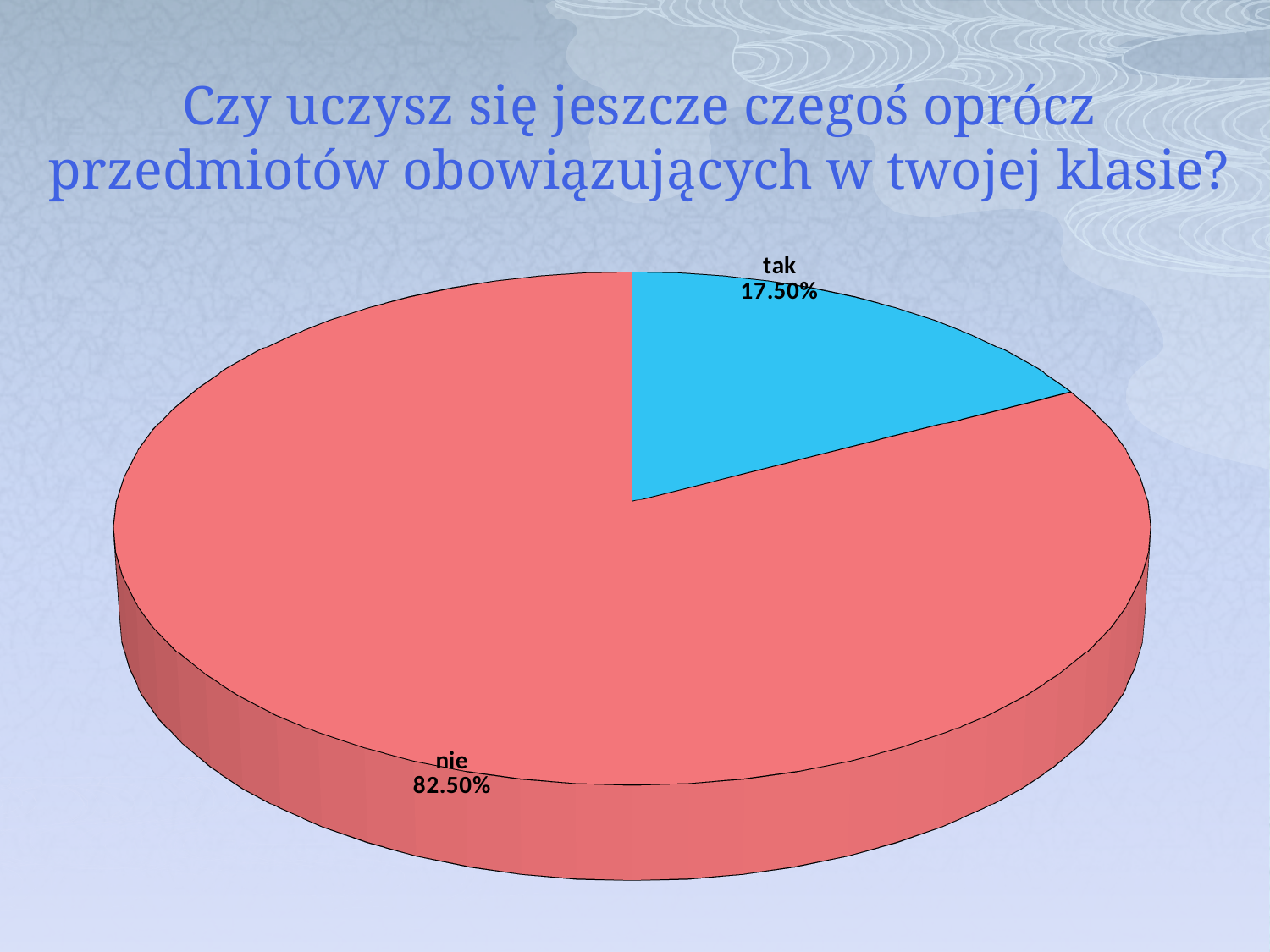
What is the difference in percentage points between the "nie" and "tak" slices? 65 percentage points What is the title of the slide above the chart? Czy uczysz się jeszcze czegoś oprócz przedmiotów obowiązujących w twojej klasie? Which slice is the largest? nie What percentage is shown for the "nie" slice? 82.50% How many slices does the pie chart have? 2 What kind of chart is shown on the slide? pie chart Which slice is the smallest? tak What percentage is shown for the "tak" slice? 17.50% Which slice is larger, "tak" or "nie"? nie What colour is the "tak" slice? blue What share of the pie does the "tak" slice represent? 17.50%